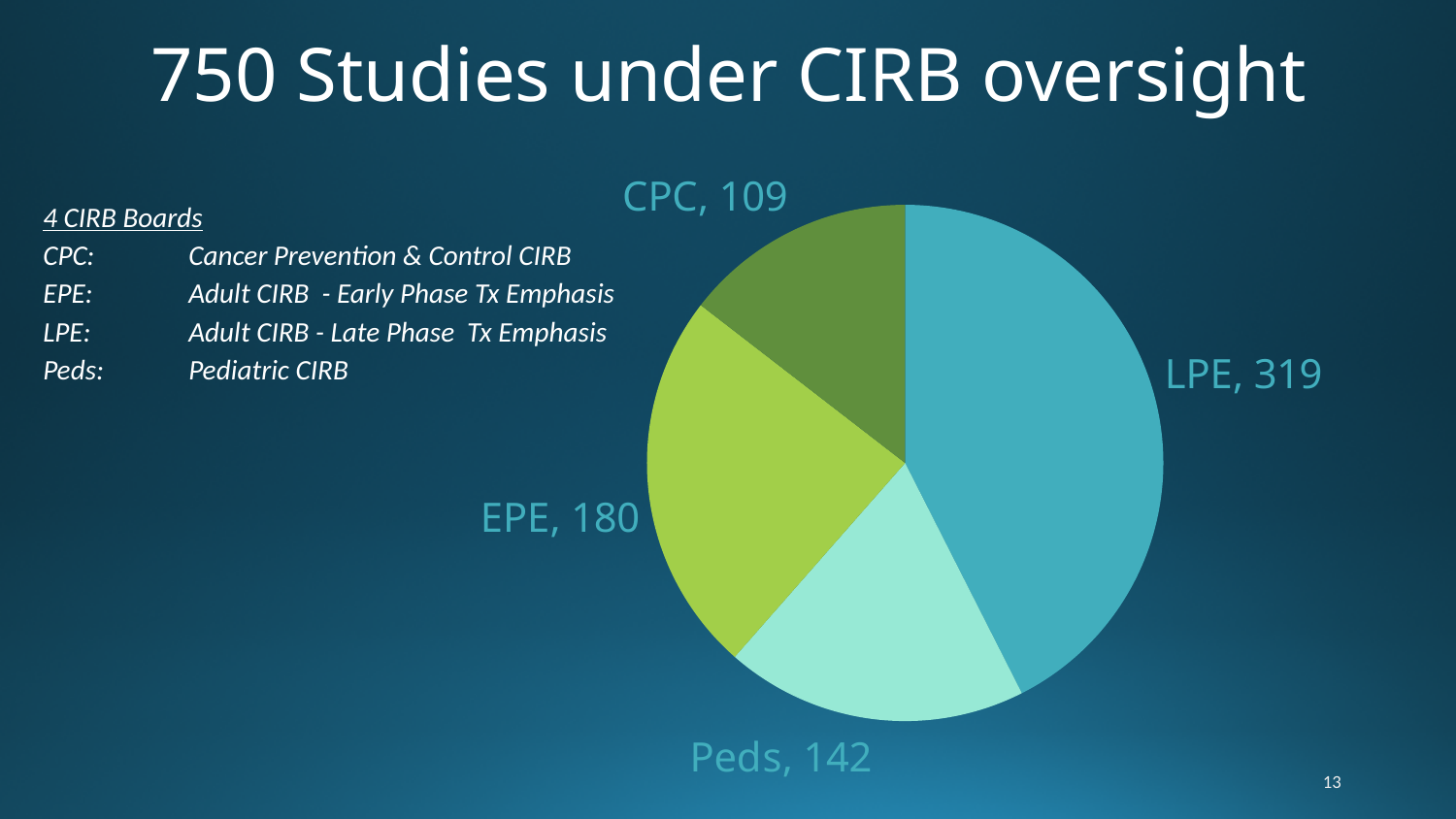
What share of the total does the EPE slice represent? 24% What is the difference between the LPE and EPE values? 139 Which category has the smallest slice of the pie chart? CPC What is the value for CPC in the pie chart? 109 Which category has the largest slice of the pie chart? LPE What is the title of the slide containing the pie chart? 750 Studies under CIRB oversight What type of chart is shown on the slide? pie chart What is the value for Peds in the pie chart? 142 What is the value for LPE in the pie chart? 319 Which is larger, the value for Peds or the value for CPC? Peds What is the value for EPE in the pie chart? 180 How many slices does the pie chart have? 4